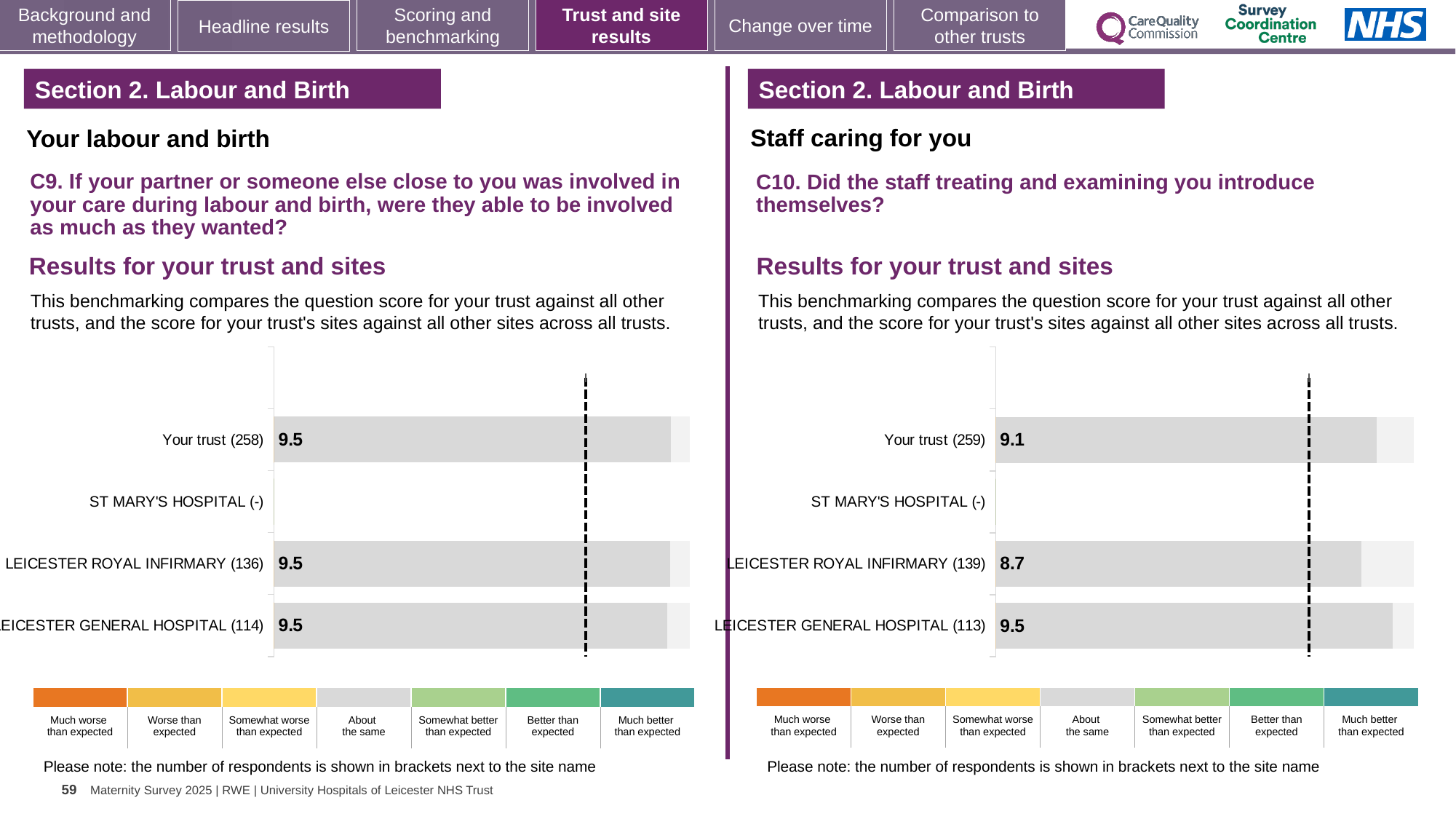
In the C9 chart on the left, which category has no bar plotted? ST MARY'S HOSPITAL (-) In the C9 chart on the left, what is the score for Your trust (258)? 9.5 In the C10 chart on the right, what is the score for LEICESTER GENERAL HOSPITAL (113)? 9.5 In the C10 chart on the right, what is the score for LEICESTER ROYAL INFIRMARY (139)? 8.7 In the C10 chart on the right, which site or trust with a plotted bar has the lowest score? LEICESTER ROYAL INFIRMARY (139) How many categories are listed on the y axis of the C9 chart on the left? 4 In the C9 chart on the left, what is the score for LEICESTER ROYAL INFIRMARY (136)? 9.5 In the C10 chart on the right, what is the score for Your trust (259)? 9.1 What kind of chart is the C9 chart on the left? Bar chart In the C10 chart on the right, which is larger: the score for Your trust (259) or for LEICESTER ROYAL INFIRMARY (139)? Your trust (259) In the C10 chart on the right, what is the difference between the scores for LEICESTER GENERAL HOSPITAL (113) and LEICESTER ROYAL INFIRMARY (139)? 0.8 In the C10 chart on the right, which site or trust has the highest score? LEICESTER GENERAL HOSPITAL (113)